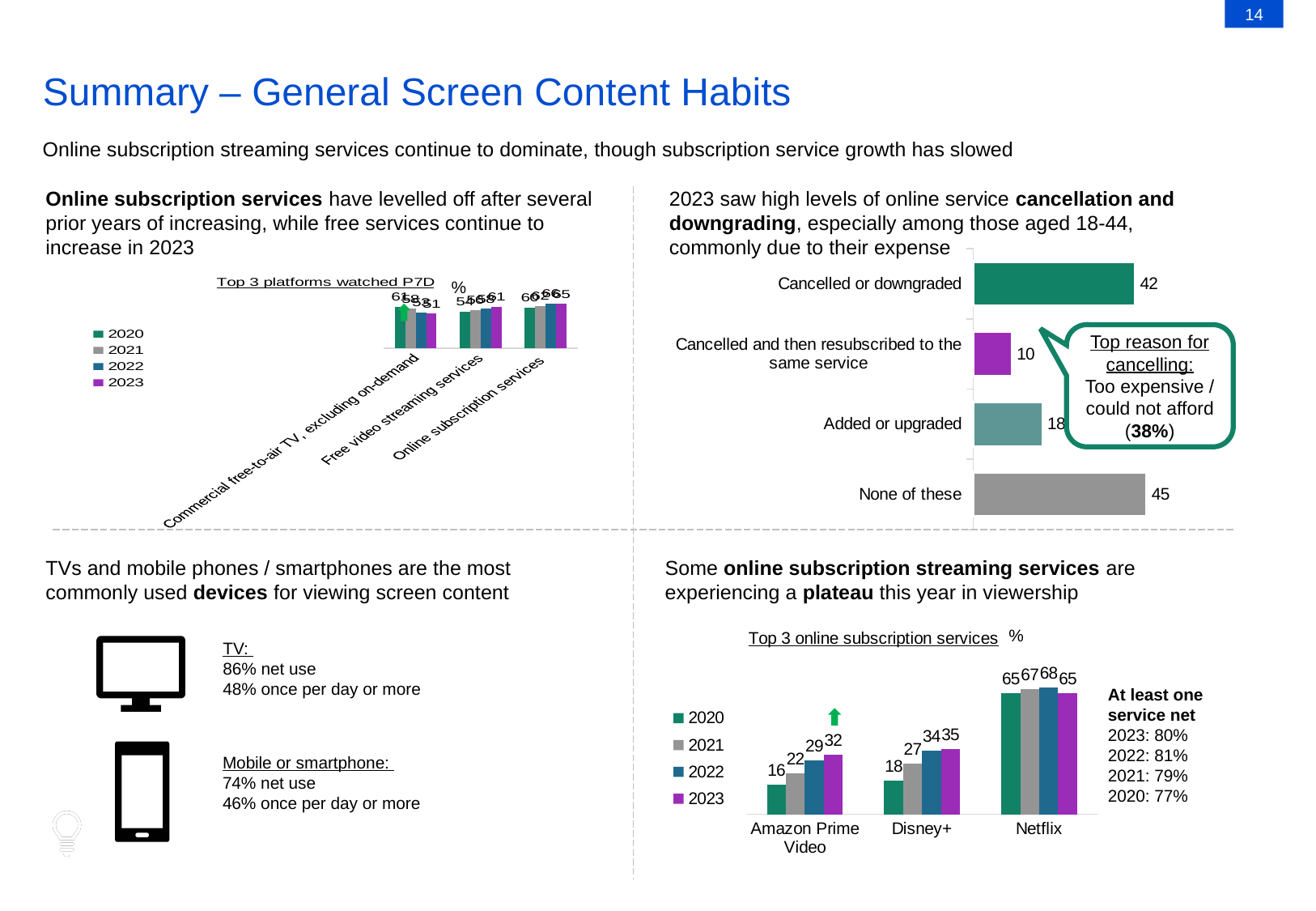
In the top-right bar chart about cancellation and downgrading, what is the difference between "None of these" and "Cancelled or downgraded"? 3 In the top-right bar chart about cancellation and downgrading, what is the value for "Cancelled or downgraded"? 42 In the top-right bar chart about cancellation and downgrading, which category has the highest value? None of these In the "Top 3 online subscription services" chart, which service has the highest 2023 value? Netflix How many categories are shown in the top-right bar chart about cancellation and downgrading? 4 In the top-right bar chart about cancellation and downgrading, what is the value for "Added or upgraded"? 18 In the "Top 3 online subscription services" chart, what is the difference between the 2023 and 2020 values for Amazon Prime Video? 16 In the "Top 3 online subscription services" chart, do the values for Disney+ rise or fall from 2020 to 2023? rise In the top-right bar chart about cancellation and downgrading, which category has the lowest value? Cancelled and then resubscribed to the same service In the "Top 3 online subscription services" chart, what is the 2023 value for Amazon Prime Video? 32 In the "Top 3 online subscription services" chart, what is the 2020 value for Disney+? 18 How many series does the legend of the "Top 3 online subscription services" chart list? 4